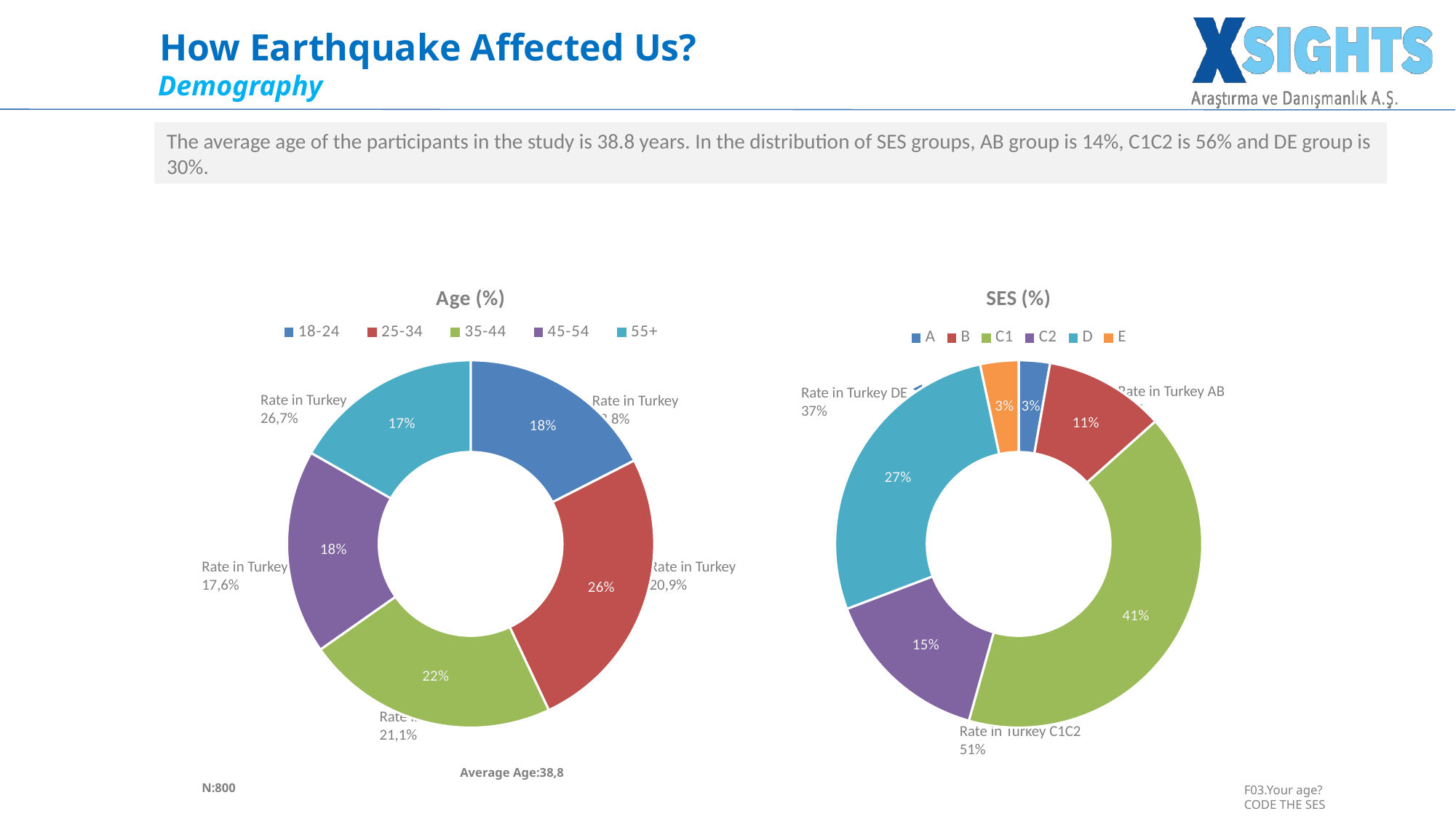
In the Age (%) chart, what percentage is shown for the 25-34 group? 26% In the SES (%) chart, which is larger, the share for B or the share for C2? C2 In the Age (%) chart, which age group has the smallest share? 55+ In the SES (%) chart, what percentage is shown for C1? 41% In the SES (%) chart, which SES group has the largest share? C1 In the Age (%) chart, which age group has the largest share? 25-34 In the SES (%) chart, what percentage is shown for D? 27% In the SES (%) chart, how many SES groups does the legend list? 6 What kind of chart is the SES (%) chart? doughnut chart In the Age (%) chart, what percentage is shown for the 55+ group? 17% In the Age (%) chart, what is the difference between the 25-34 share and the 35-44 share? 4% In the Age (%) chart, how many age groups does the legend list? 5